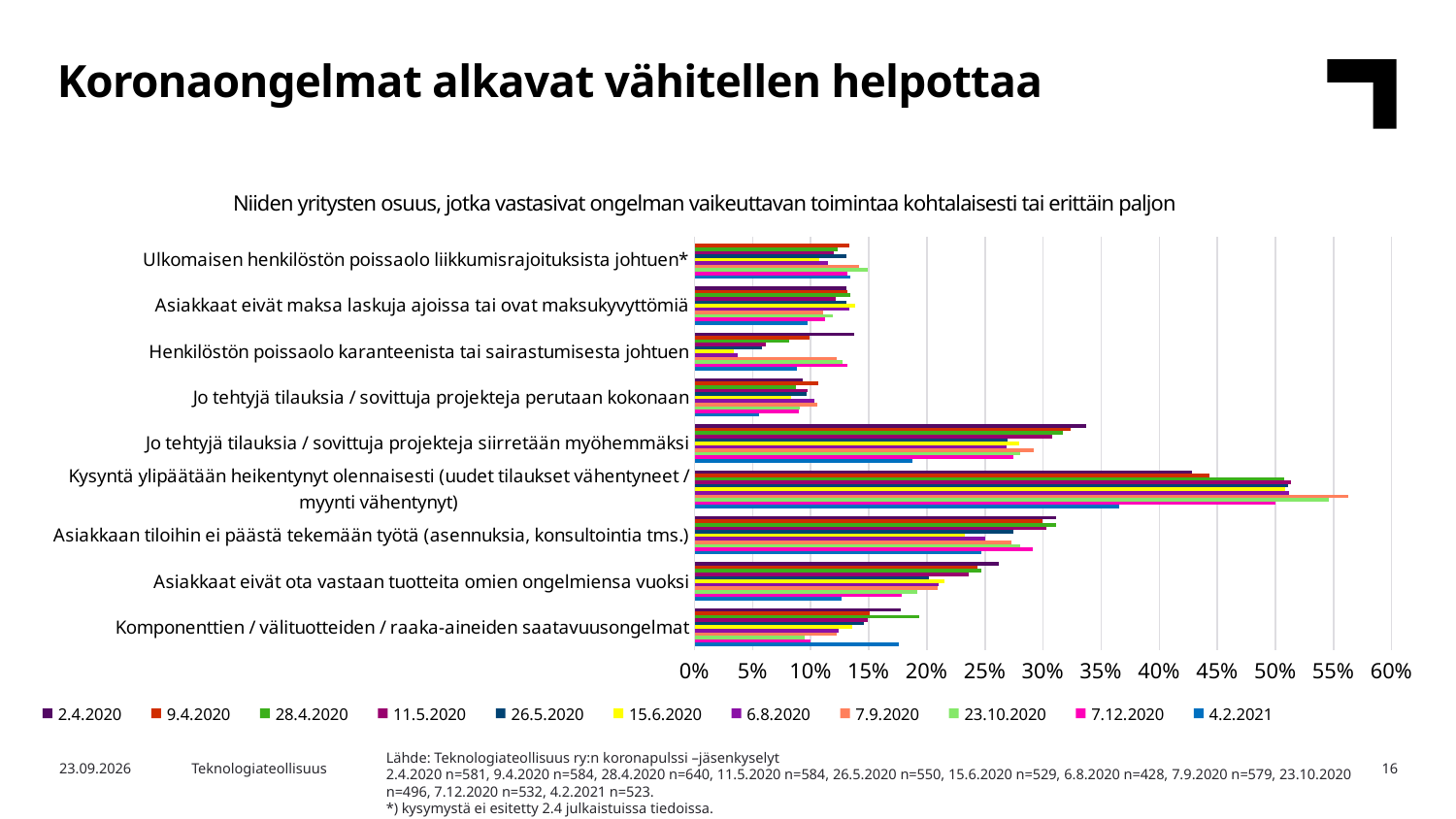
Is the 2.4.2020 value for 'Jo tehtyjä tilauksia / sovittuja projekteja siirretään myöhemmäksi' greater or less than 30%? greater Is the 7.9.2020 value for 'Kysyntä ylipäätään heikentynyt olennaisesti' greater or less than 50%? greater Which category has the longest bars on the chart? Kysyntä ylipäätään heikentynyt olennaisesti (uudet tilaukset vähentyneet / myynti vähentynyt) How many series does the legend list? 11 For the 2.4.2020 series, which is larger: 'Jo tehtyjä tilauksia / sovittuja projekteja perutaan kokonaan' or 'Kysyntä ylipäätään heikentynyt olennaisesti'? Kysyntä ylipäätään heikentynyt olennaisesti How many categories are plotted on the chart? 9 What is the title of the chart? Niiden yritysten osuus, jotka vastasivat ongelman vaikeuttavan toimintaa kohtalaisesti tai erittäin paljon What kind of chart is shown on the slide? bar chart For 'Kysyntä ylipäätään heikentynyt olennaisesti', which is larger: the 7.9.2020 value or the 4.2.2021 value? 7.9.2020 Is the 4.2.2021 value for 'Komponenttien / välituotteiden / raaka-aineiden saatavuusongelmat' greater or less than 15%? greater